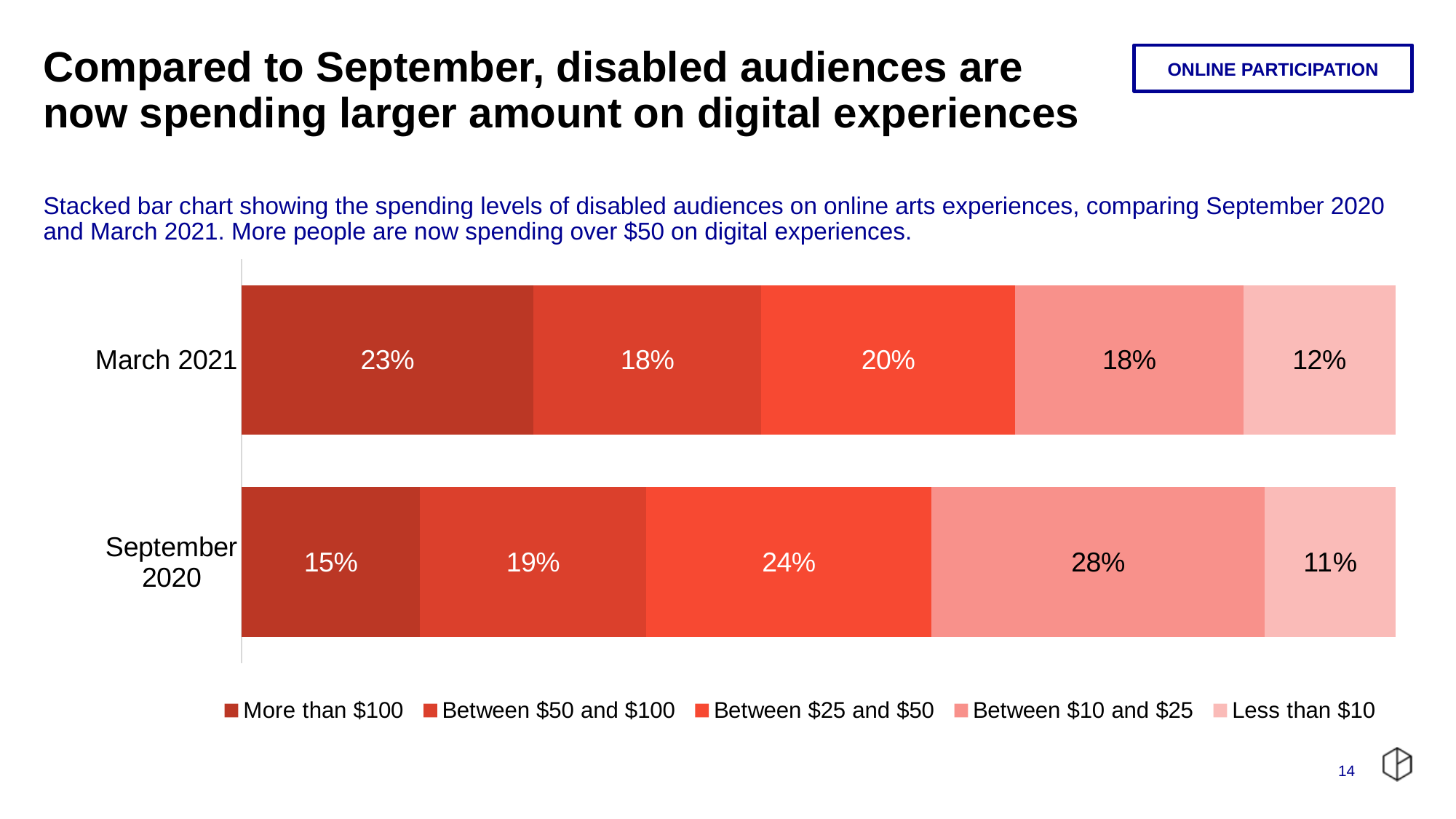
What type of chart is shown on the slide? Stacked bar chart Which period has the larger share for 'Between $10 and $25', March 2021 or September 2020? September 2020 What is the combined share of people spending more than $50 in March 2021? 41% How many spending levels does the legend list? 5 What is the value for 'Between $25 and $50' in September 2020? 24% How many periods (bars) are shown in the chart? 2 By how many percentage points did the 'More than $100' share change from September 2020 to March 2021? 8 percentage points Which spending level has the smallest share in March 2021? Less than $10 What percentage of disabled audiences spent more than $100 in March 2021? 23% What is the value for 'Less than $10' in March 2021? 12% Which spending level has the largest share in September 2020? Between $10 and $25 What percentage of disabled audiences spent between $10 and $25 in September 2020? 28%